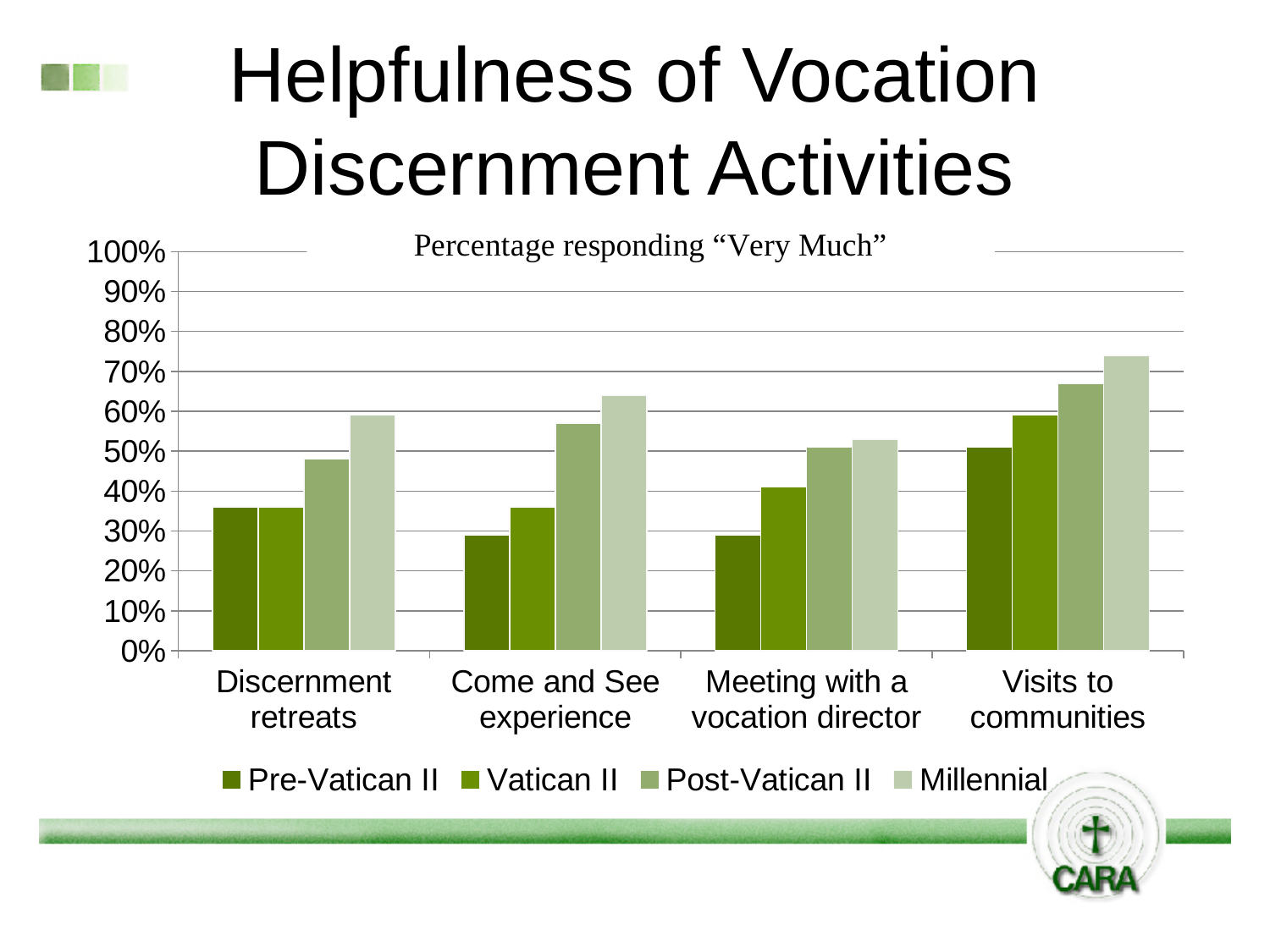
Is the Post-Vatican II value for Discernment retreats greater or less than 40%? greater How many vocation discernment activities are shown along the x axis? 4 How many series does the legend list? 4 For Visits to communities, which is larger: the Millennial value or the Pre-Vatican II value? Millennial Which activity and generation has the tallest bar in the chart? Millennial, Visits to communities Is the Millennial value for Come and See experience greater or less than 60%? greater Is the Pre-Vatican II value for Come and See experience greater or less than 40%? less Which generation has the lowest value for Visits to communities? Pre-Vatican II What subtitle appears above the chart's plot area? Percentage responding "Very Much" What kind of chart is shown on the slide? bar chart For Visits to communities, do the bars rise or fall going from Pre-Vatican II to Millennial? rise